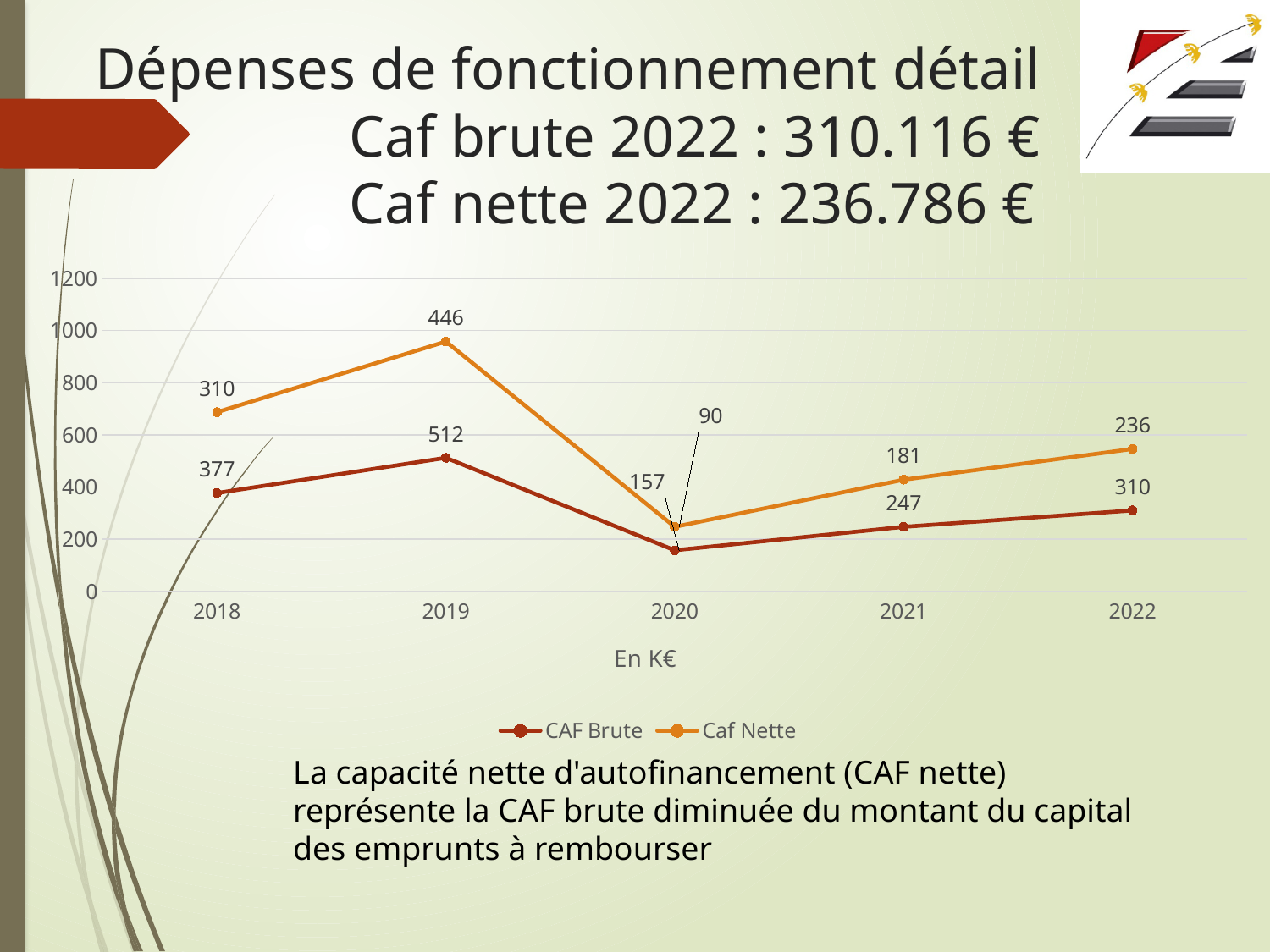
What is the difference between CAF Brute and Caf Nette in 2022? 74 In which year is CAF Brute highest? 2019 In which year is Caf Nette lowest? 2020 How many years are shown on the x axis? 5 What kind of chart is shown on the slide? line chart How many series does the legend list? 2 Does CAF Brute rise or fall from 2020 to 2022? rise What is the value of CAF Brute in 2022? 310 What is the value of Caf Nette in 2020? 90 What is the value of CAF Brute in 2019? 512 What is the value of Caf Nette in 2021? 181 Which is larger for CAF Brute: the value in 2019 or the value in 2021? 2019